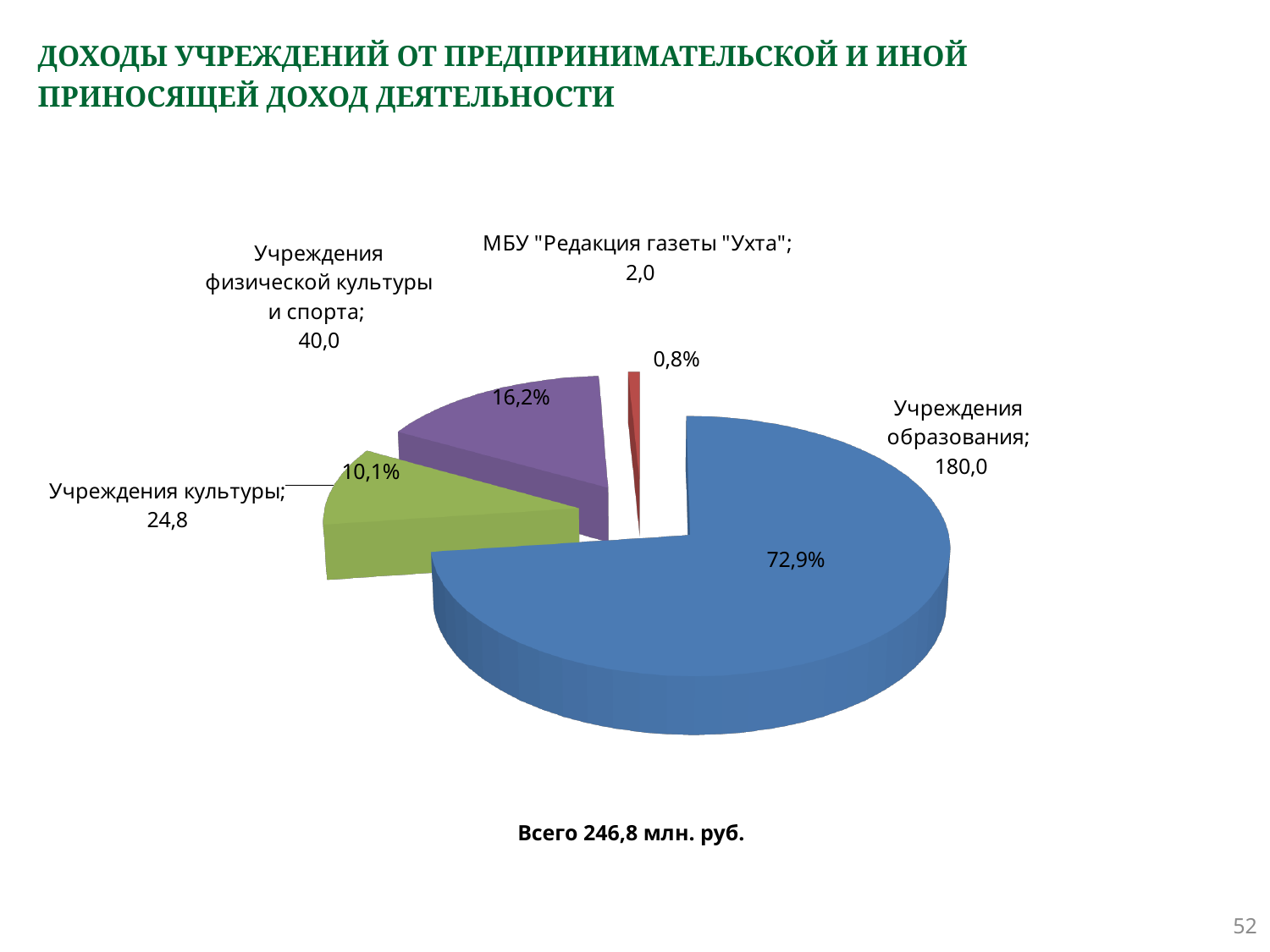
What type of chart is shown on the slide? Pie chart What is the difference between the values for Учреждения физической культуры и спорта and Учреждения культуры? 15,2 What is the value for Учреждения физической культуры и спорта? 40,0 Which category has the largest slice? Учреждения образования What total is stated below the chart? 246,8 млн. руб. What is the value for Учреждения образования? 180,0 What is the value for Учреждения культуры? 24,8 What share of the pie does Учреждения образования represent? 72,9% Which category has the smallest slice? МБУ "Редакция газеты "Ухта" What is the value for МБУ "Редакция газеты "Ухта"? 2,0 How many slices does the pie chart have? 4 What share of the pie does Учреждения культуры represent? 10,1%